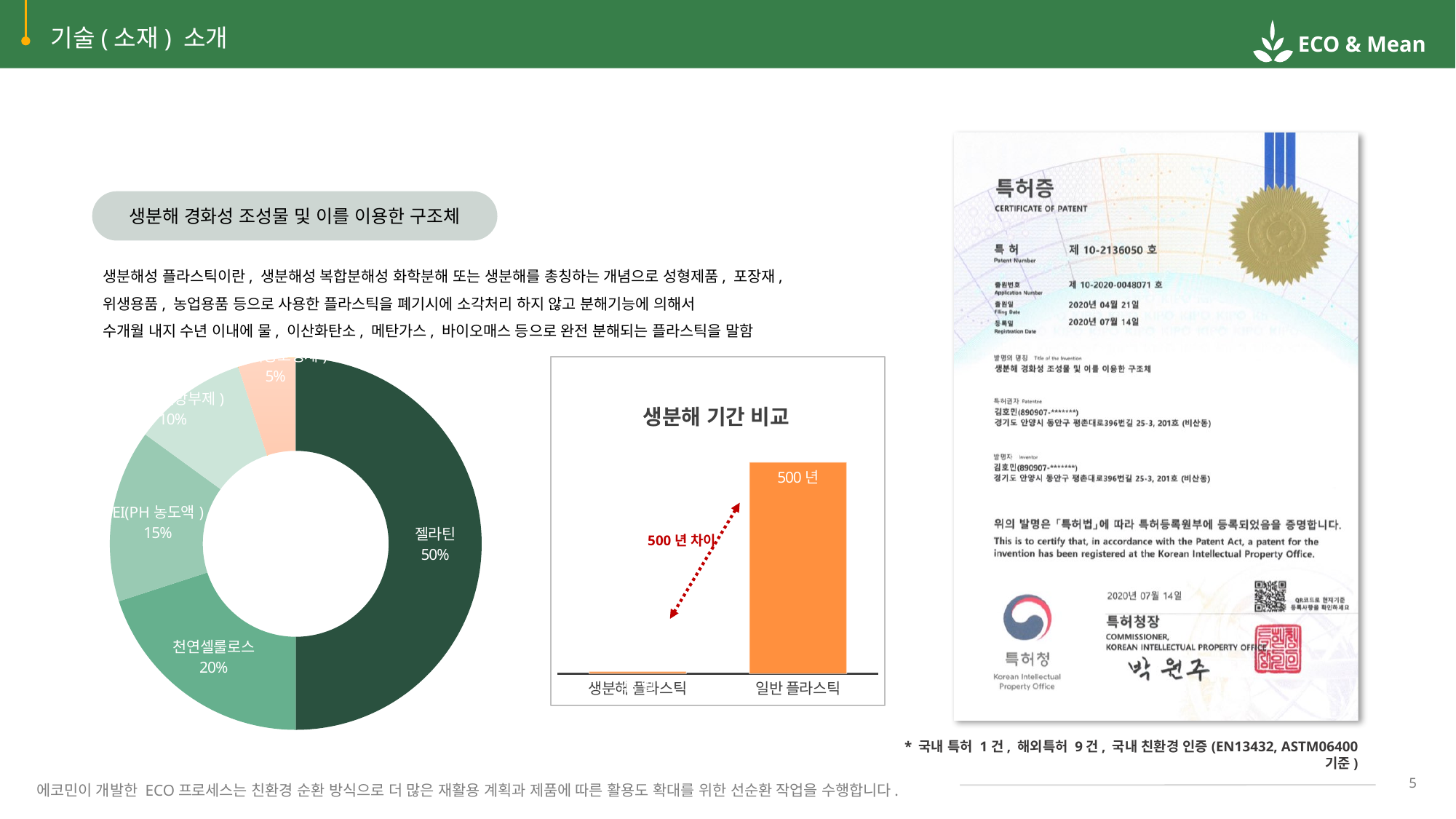
What kind of chart is the chart titled 생분해 기간 비교? bar chart How many slices does the pie chart on the left have? 5 What kind of chart is the chart on the left of the slide? doughnut chart How many categories are shown in the chart titled 생분해 기간 비교? 2 In the pie chart on the left, what is the value for 젤라틴? 50% In the pie chart on the left, what is the value for 천연셀룰로스? 20% In the pie chart on the left, which is larger: 젤라틴 or 천연셀룰로스? 젤라틴 In the pie chart on the left, which category has the largest slice? 젤라틴 In the pie chart on the left, what is the difference between the values for 젤라틴 and 천연셀룰로스? 30% In the chart titled 생분해 기간 비교, which category has the lowest value? 생분해 플라스틱 In the chart titled 생분해 기간 비교, what is the value for 일반 플라스틱? 500 년 What is the title of the bar chart in the middle of the slide? 생분해 기간 비교